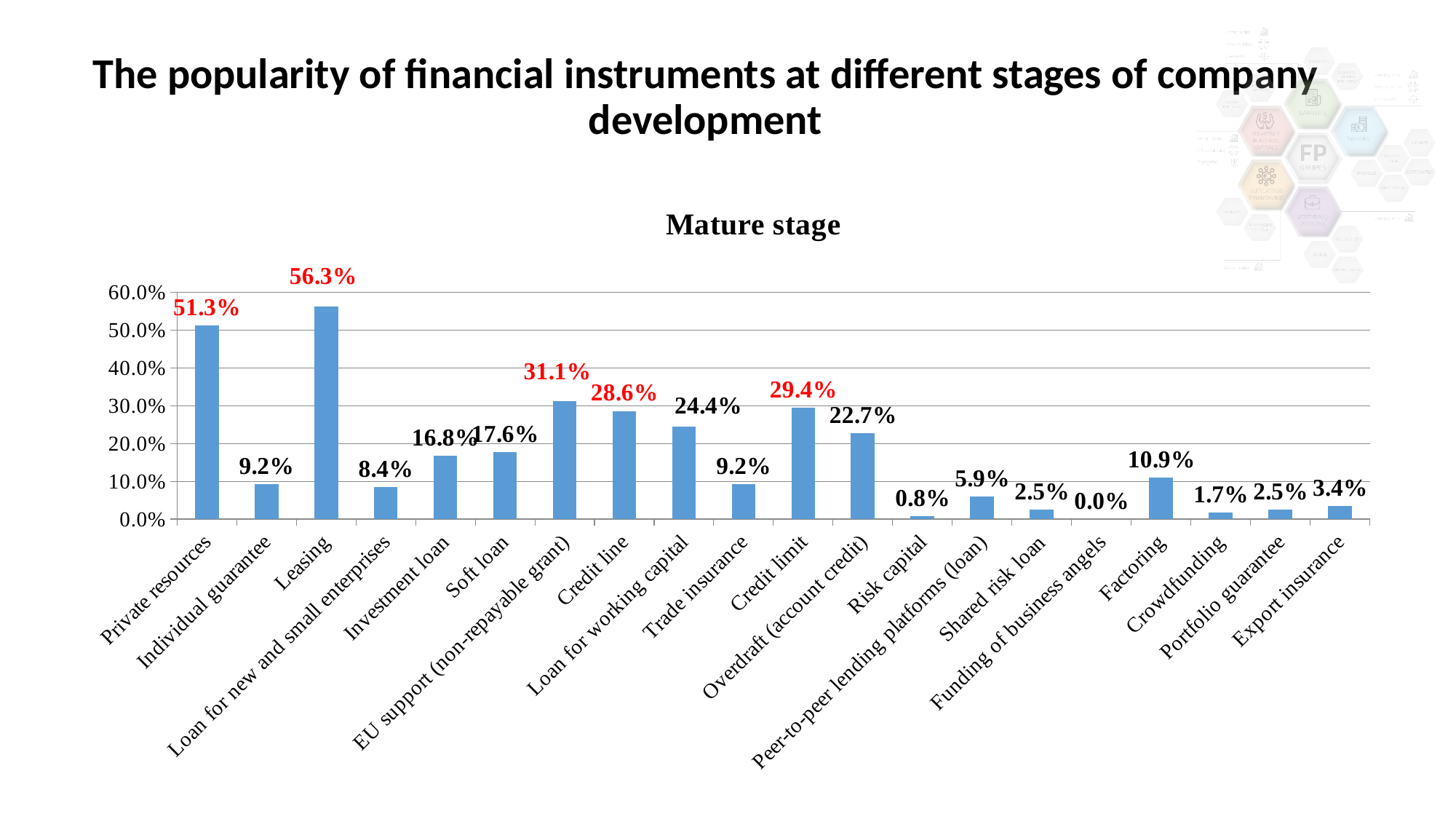
What is the value for Funding of business angels? 0.0% What kind of chart is shown on the slide? Bar chart What is the value for Factoring? 10.9% What is the title of the chart? Mature stage Which is larger, the value for Loan for working capital or the value for Overdraft (account credit)? Loan for working capital What is the difference between the values for Leasing and Private resources? 5.0% Which category has the highest value? Leasing How many categories are shown on the chart? 20 Which category has the lowest value? Funding of business angels What is the value for Leasing? 56.3% What is the difference between the values for EU support (non-repayable grant) and Credit line? 2.5% What is the value for Credit limit? 29.4%